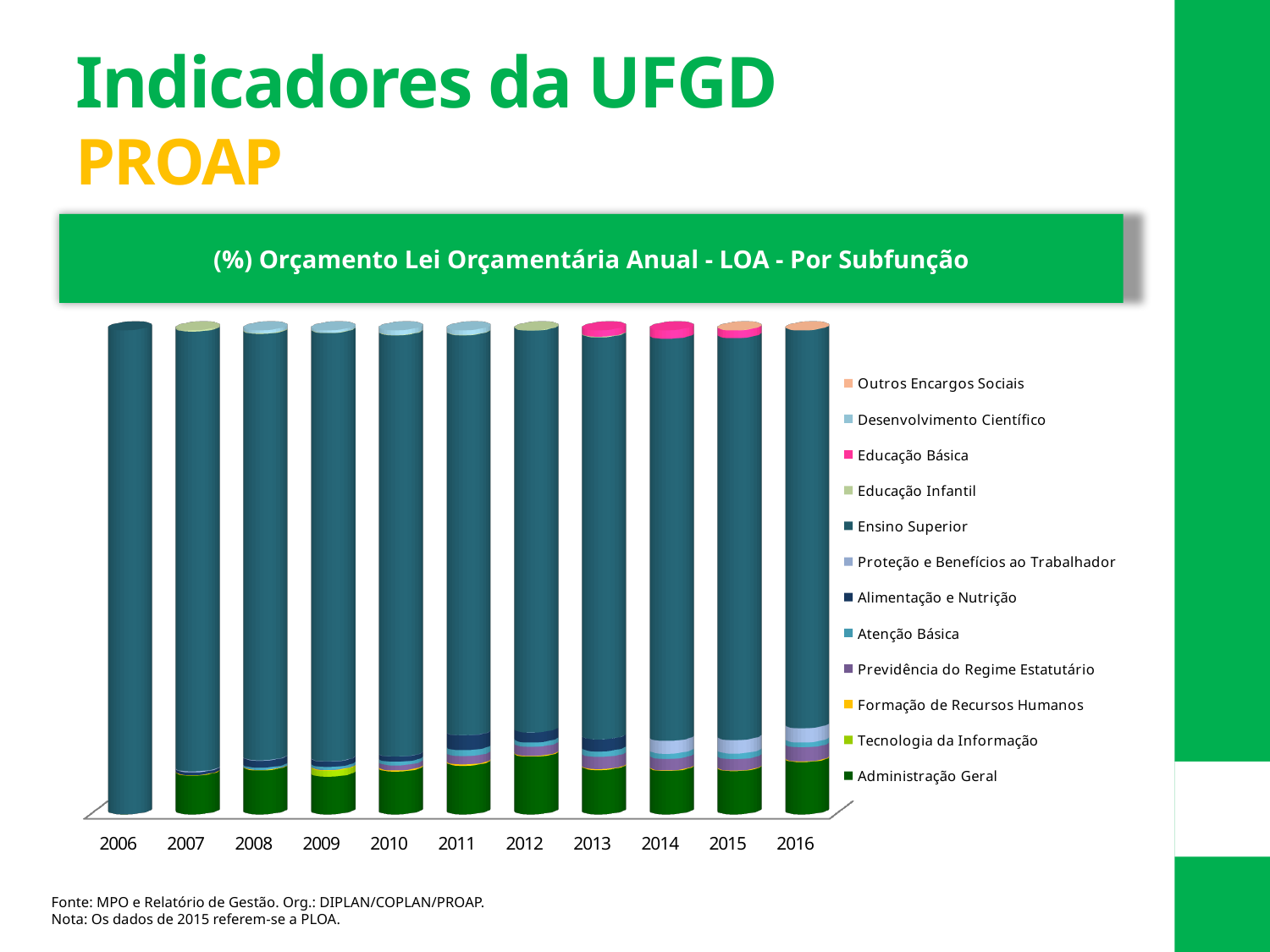
In 2014, which is larger: the Ensino Superior segment or the Administração Geral segment? Ensino Superior Which subfunction makes up the largest part of the bar for 2006? Ensino Superior Which legend entry is listed at the bottom of the legend? Administração Geral What is the last year shown on the x axis? 2016 How many series does the chart's legend list? 12 Which subfunction makes up the largest part of the bar for 2016? Ensino Superior How many years are shown along the x axis of the chart? 11 What is the title of the chart? (%) Orçamento Lei Orçamentária Anual - LOA - Por Subfunção What is the first year shown on the x axis? 2006 Which is larger in 2006: the Ensino Superior segment or the Administração Geral segment? Ensino Superior What kind of chart is shown on the slide? Stacked bar chart